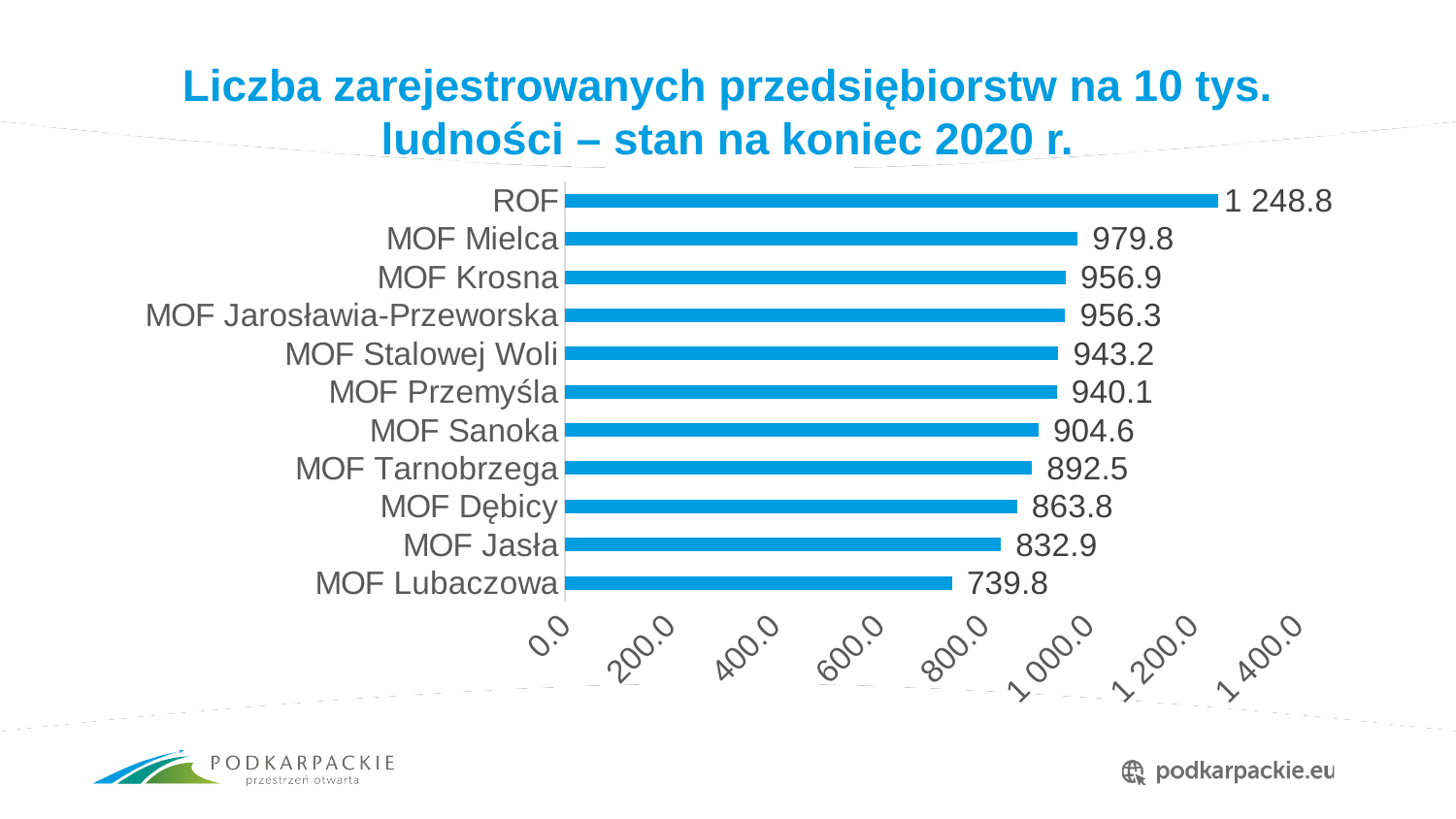
Which category has the highest value? ROF What kind of chart is shown on the slide? bar chart What is the difference between the values for MOF Jasła and MOF Lubaczowa? 93.1 What is the value for ROF? 1 248.8 How many categories are shown in the chart? 11 What is the title of the chart? Liczba zarejestrowanych przedsiębiorstw na 10 tys. ludności – stan na koniec 2020 r. What is the value for MOF Lubaczowa? 739.8 What is the value for MOF Stalowej Woli? 943.2 Is the value for MOF Tarnobrzega greater or less than 1 000.0? less Which category has the lowest value? MOF Lubaczowa What is the difference between the values for ROF and MOF Mielca? 269.0 Which is larger, the value for MOF Sanoka or the value for MOF Dębicy? MOF Sanoka